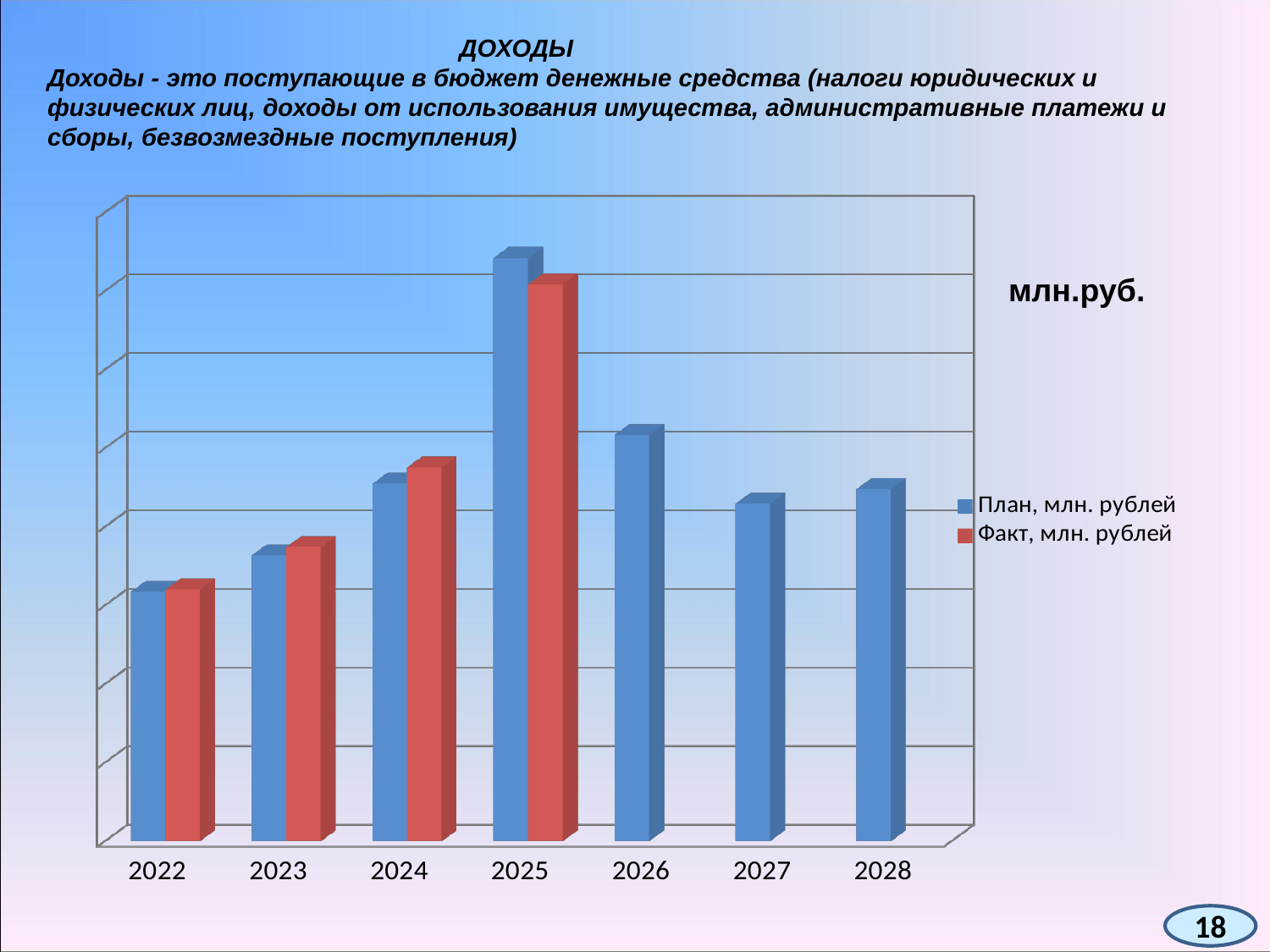
Do the values for "План, млн. рублей" rise or fall from 2022 to 2025? Rise How many years are shown on the x axis of the chart? 7 In 2024, which is larger: the "План, млн. рублей" value or the "Факт, млн. рублей" value? Факт, млн. рублей In 2025, which is larger: the "План, млн. рублей" value or the "Факт, млн. рублей" value? План, млн. рублей Which year has the highest value for the series "Факт, млн. рублей"? 2025 For how many years does the chart show a "Факт, млн. рублей" bar? 4 Which year has the lowest value for the series "Факт, млн. рублей"? 2022 How many series does the chart legend list? 2 Which year has the lowest value for the series "План, млн. рублей"? 2022 What are the two entries listed in the chart legend? План, млн. рублей; Факт, млн. рублей Which year has the highest value for the series "План, млн. рублей"? 2025 What kind of chart is shown on the slide? Bar chart